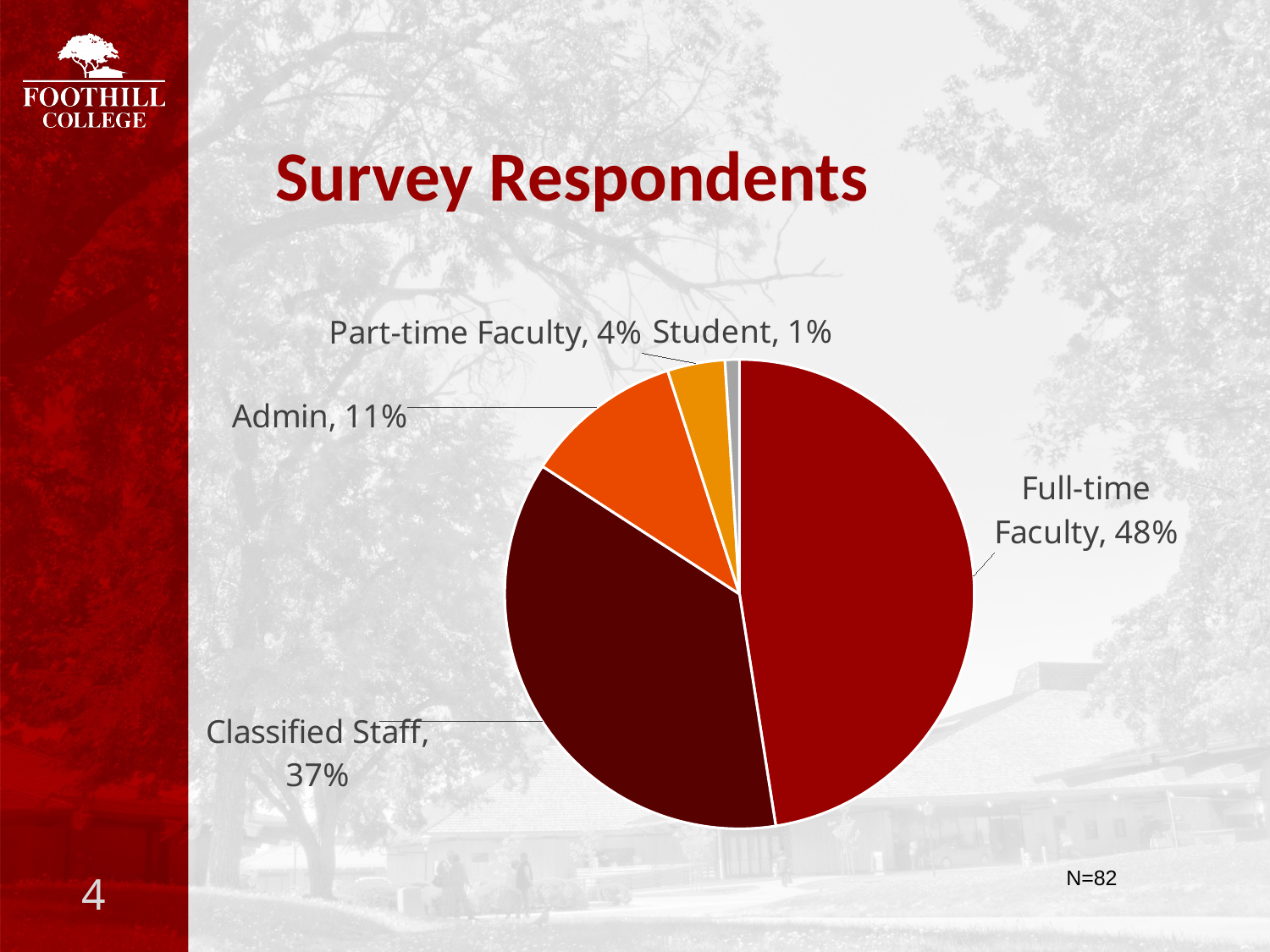
What share of survey respondents are Full-time Faculty? 48% Which respondent group has the smallest share of the pie? Student Which respondent group has the largest share of the pie? Full-time Faculty What is the difference in percentage points between Full-time Faculty and Classified Staff? 11 How many respondent groups are shown in the pie chart? 5 What kind of chart is shown on the slide? Pie chart What share of survey respondents are Part-time Faculty? 4% What share of survey respondents are Classified Staff? 37% Which group has a larger share, Admin or Part-time Faculty? Admin What is the total number of survey respondents (N) noted on the slide? 82